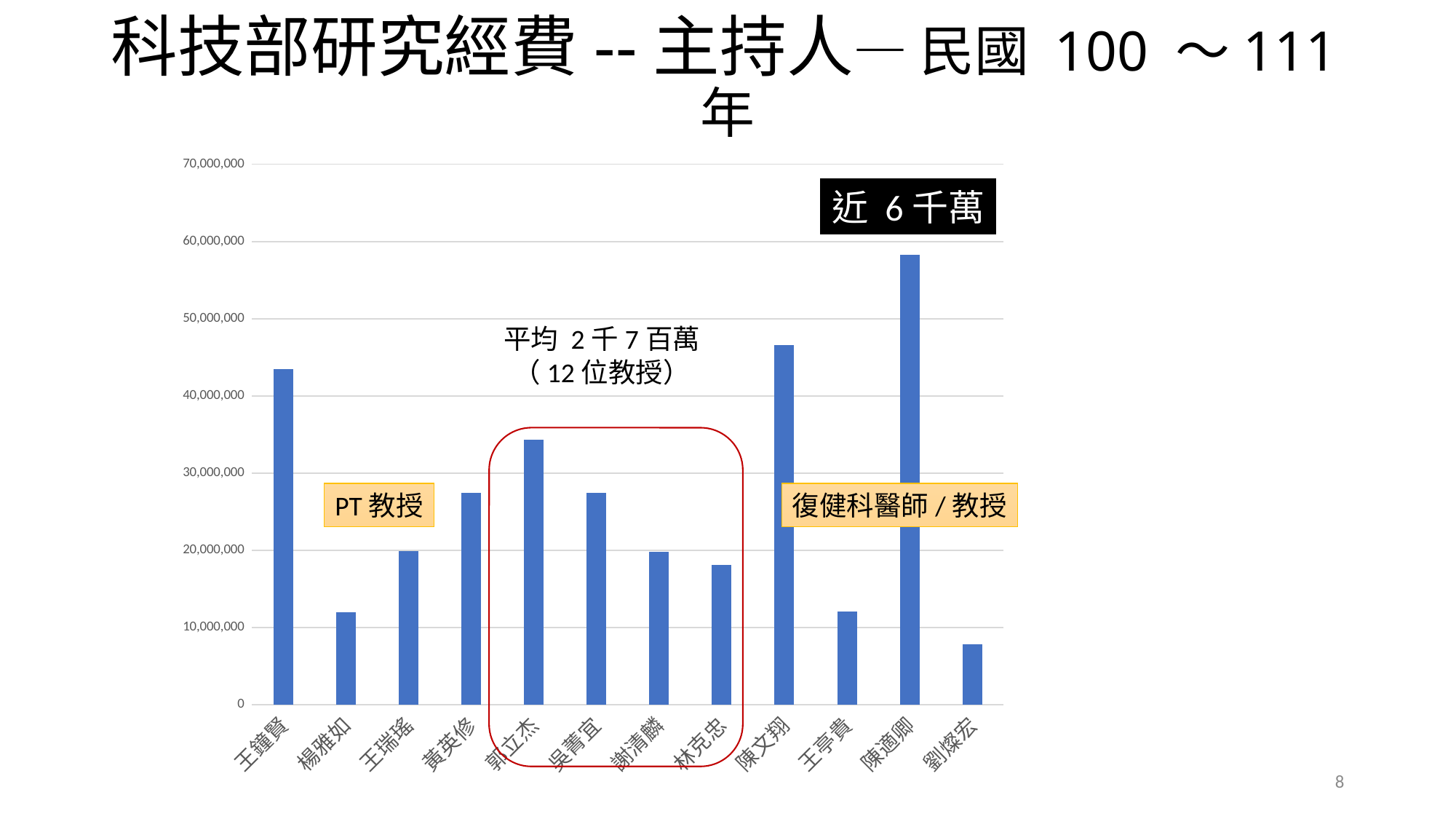
Which has the larger value, 郭立杰 or 黃英修? 郭立杰 Is the value for 王鐘賢 greater or less than 40,000,000? greater Which principal investigator has the lowest research funding? 劉燦宏 What kind of chart is shown on the slide? bar chart How many principal investigators (categories) are shown on the x axis? 12 According to the annotation on the chart, what is the average funding across the 12 professors? 2 千 7 百萬 Which principal investigator has the highest research funding? 陳適卿 Which has the larger value, 陳適卿 or 陳文翔? 陳適卿 Is the value for 郭立杰 greater or less than 30,000,000? greater Is the value for 陳適卿 greater or less than 50,000,000? greater